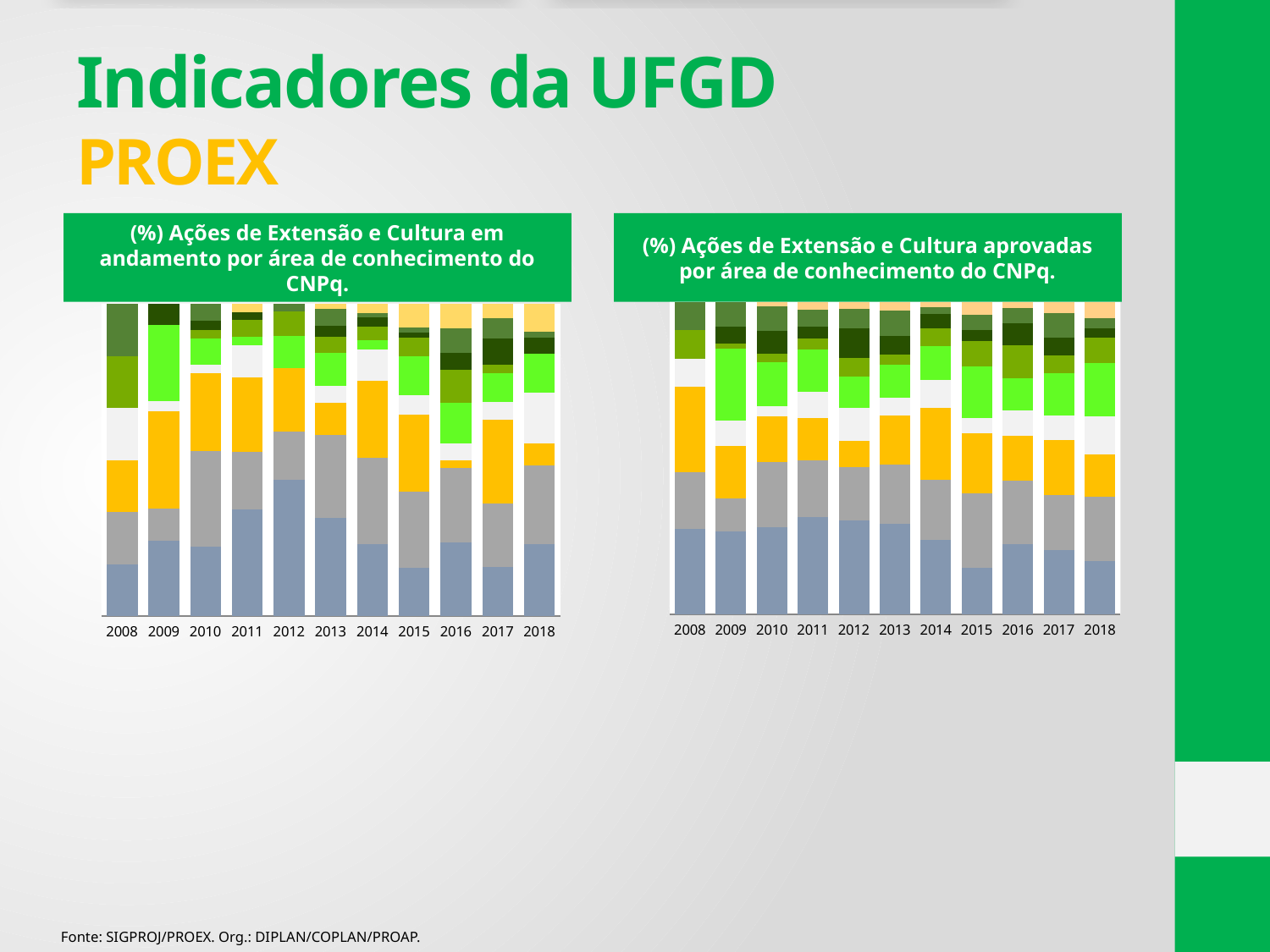
What is the title of the right chart on the slide? (%) Ações de Extensão e Cultura aprovadas por área de conhecimento do CNPq. What kind of chart is the left chart on the slide? Stacked bar chart In the chart titled "(%) Ações de Extensão e Cultura em andamento por área de conhecimento do CNPq.", how many years are shown on the x axis? 11 What is the title of the left chart on the slide? (%) Ações de Extensão e Cultura em andamento por área de conhecimento do CNPq. What kind of chart is the right chart on the slide? Stacked bar chart In the chart titled "(%) Ações de Extensão e Cultura aprovadas por área de conhecimento do CNPq.", how many years are shown on the x axis? 11 In the left chart, which year has the tallest bottom (blue-grey) segment? 2012 In the right chart, which year has the tallest orange segment? 2008